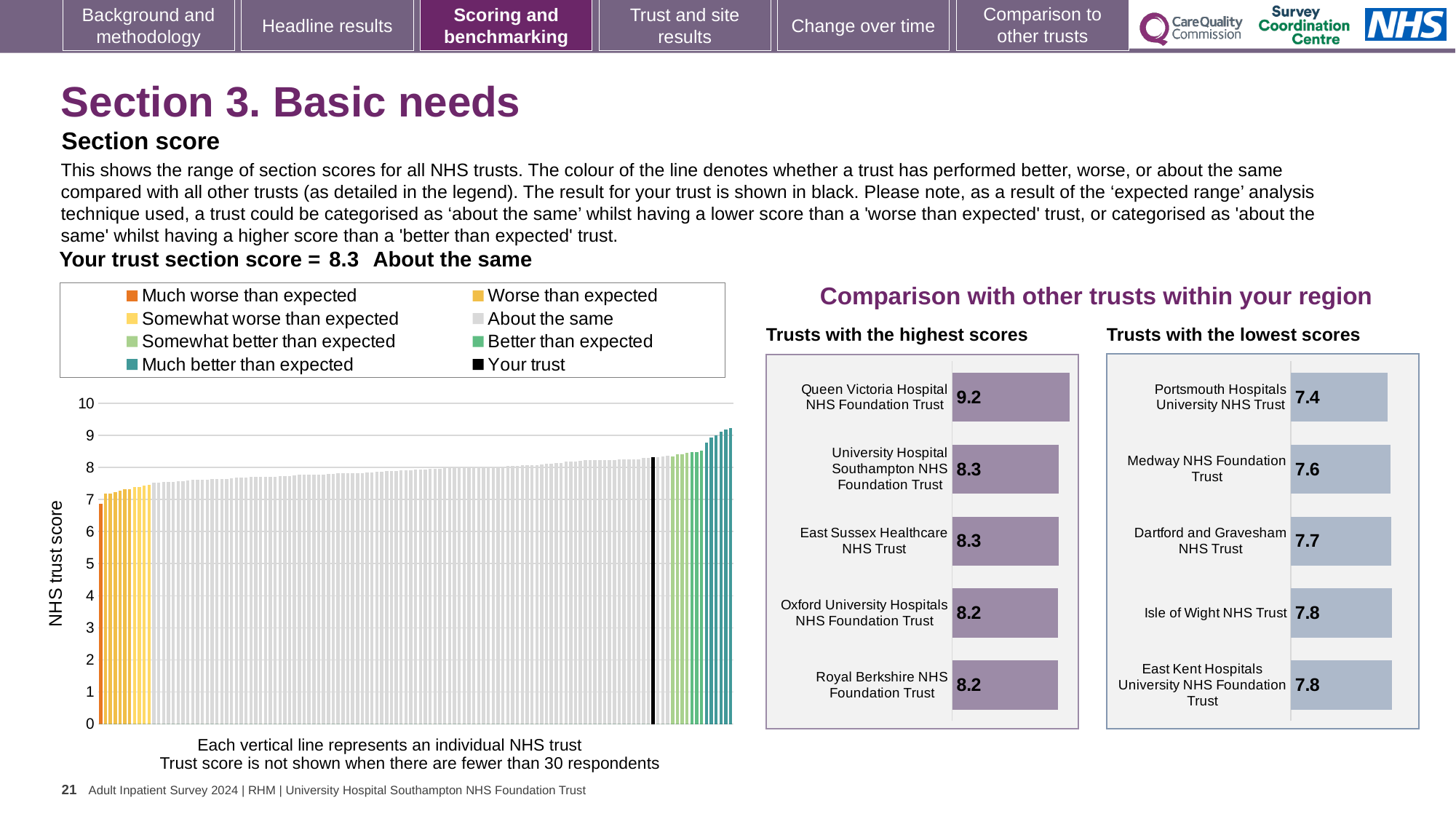
In the 'Trusts with the lowest scores' chart, what is the score for Portsmouth Hospitals University NHS Trust? 7.4 In the 'Trusts with the lowest scores' chart, what is the difference between the scores of East Kent Hospitals University NHS Foundation Trust and Portsmouth Hospitals University NHS Trust? 0.4 In the 'Trusts with the lowest scores' chart, what is the score for Dartford and Gravesham NHS Trust? 7.7 How many entries does the legend of the large chart on the left list? 8 How many trusts are shown in the 'Trusts with the highest scores' chart? 5 In the 'Trusts with the highest scores' chart, what is the difference between the scores of Queen Victoria Hospital NHS Foundation Trust and Royal Berkshire NHS Foundation Trust? 1.0 In the 'Trusts with the highest scores' chart, what is the score for Queen Victoria Hospital NHS Foundation Trust? 9.2 In the 'Trusts with the highest scores' chart, what is the score for Oxford University Hospitals NHS Foundation Trust? 8.2 In the 'Trusts with the lowest scores' chart, which trust has the lowest score? Portsmouth Hospitals University NHS Trust What type of chart is the large chart on the left showing the range of section scores for all NHS trusts? Bar chart In the 'Trusts with the highest scores' chart, which trust has the highest score? Queen Victoria Hospital NHS Foundation Trust In the 'Trusts with the lowest scores' chart, which has the larger score: Medway NHS Foundation Trust or Isle of Wight NHS Trust? Isle of Wight NHS Trust